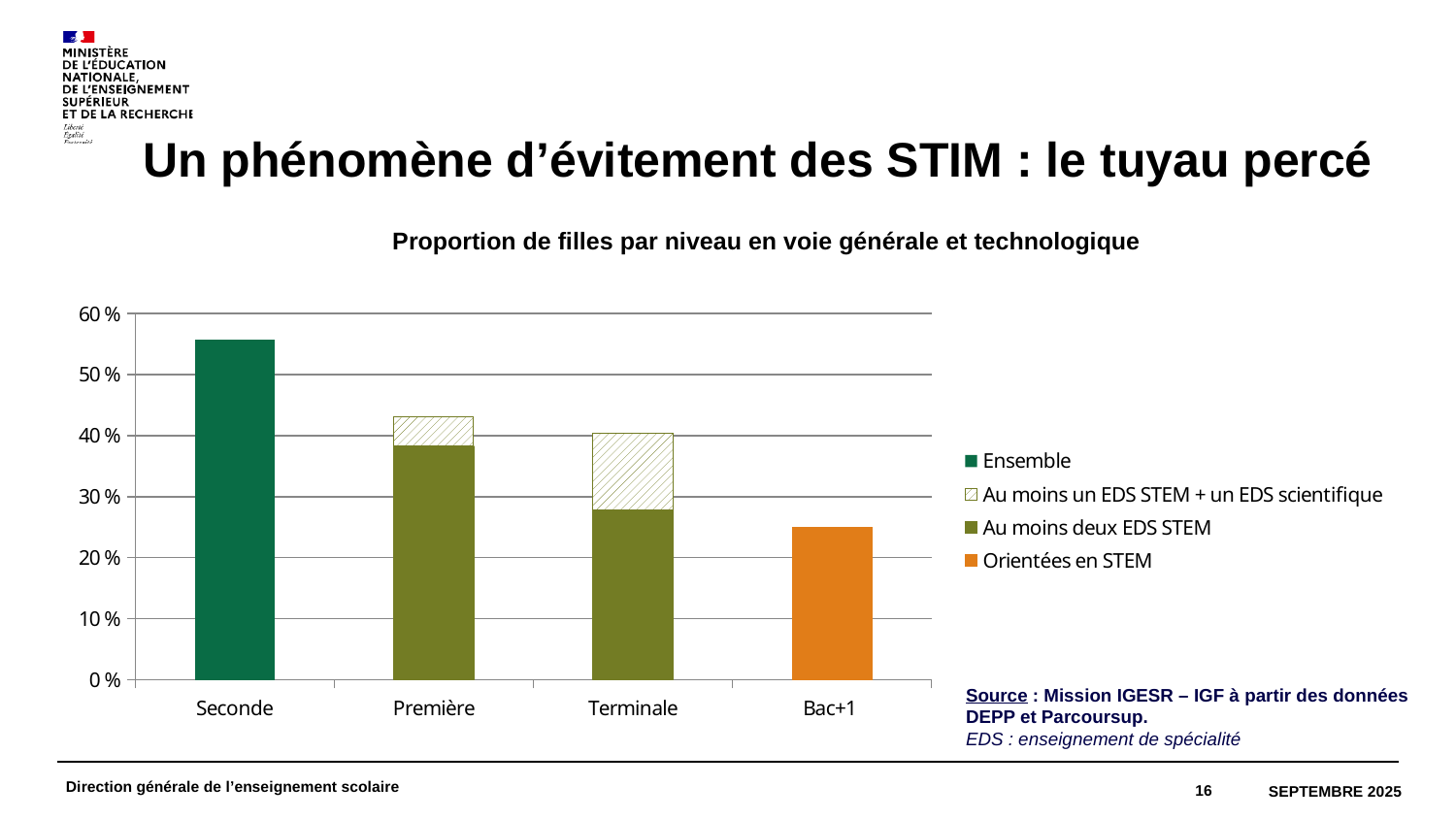
Which level has the lowest bar in the chart? Bac+1 Do the bar heights rise or fall from Seconde to Bac+1 along the x axis? fall Is the value for Bac+1 (Orientées en STEM) greater or less than 20 %? greater What kind of chart is shown on the slide? bar chart Which level has the highest bar in the chart? Seconde How many series does the chart's legend list? 4 How many categories (levels) are shown on the x axis of the chart? 4 Is the value for Bac+1 (Orientées en STEM) greater or less than 30 %? less What is the title of the chart? Proportion de filles par niveau en voie générale et technologique Is the 'Au moins deux EDS STEM' value for Première greater or less than 30 %? greater Which is larger, the bar for Seconde or the bar for Bac+1? Seconde